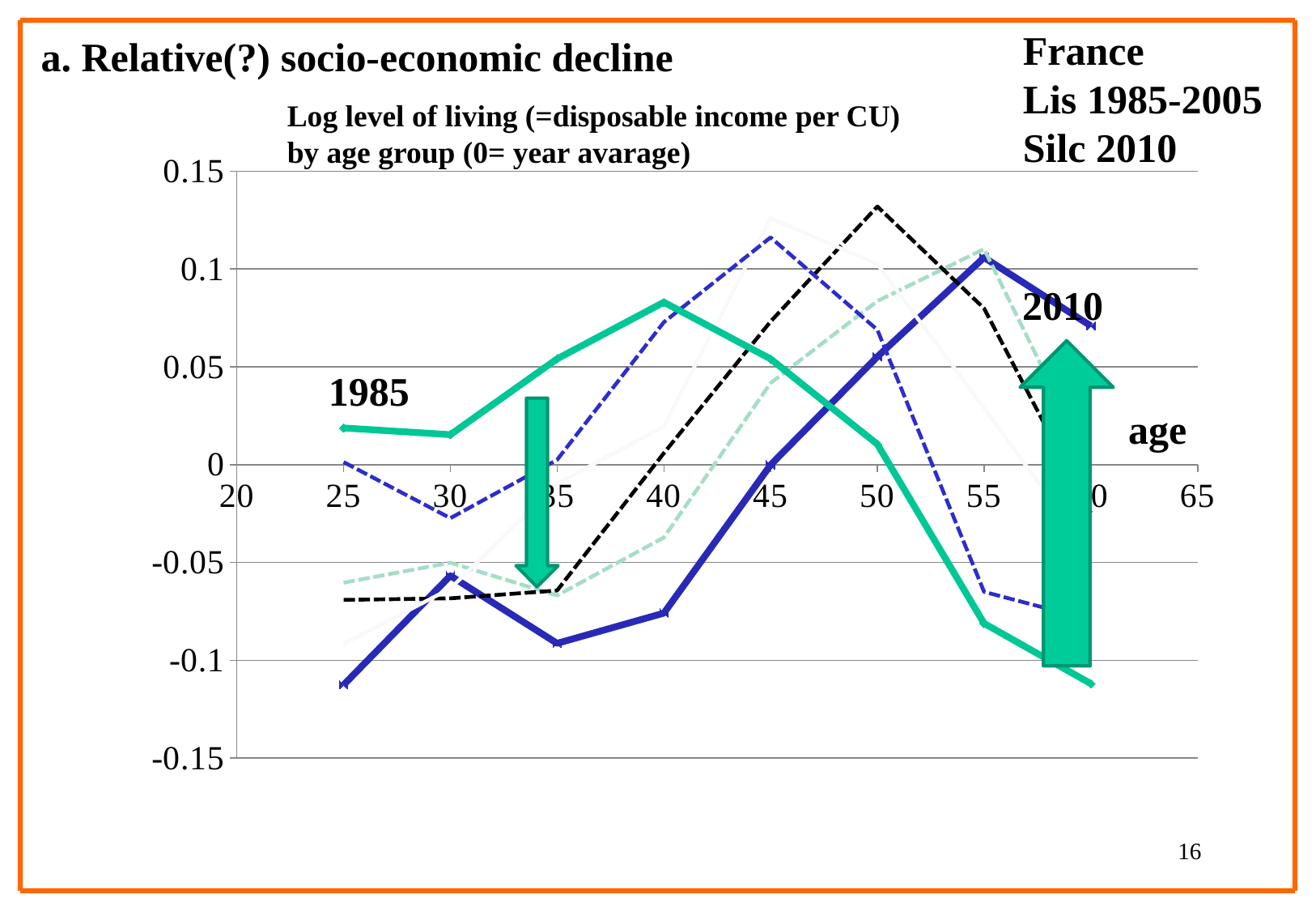
At age 25, which line has the higher value, 1985 or 2010? 1985 At which age does the 2010 line reach its highest value? 55 Is the value of the 1985 line at age 55 greater or less than -0.05? less What is the title of the chart? Log level of living (=disposable income per CU) by age group (0= year avarage) What kind of chart is shown on the slide? line chart At which age does the 1985 line reach its lowest value? 60 At age 55, which line has the higher value, 1985 or 2010? 2010 Is the value of the 1985 line at age 40 greater or less than 0.05? greater Is the value of the 2010 line at age 25 greater or less than -0.05? less At which age does the 2010 line reach its lowest value? 25 What variable is plotted on the x axis of the chart? age At which age does the 1985 line reach its highest value? 40